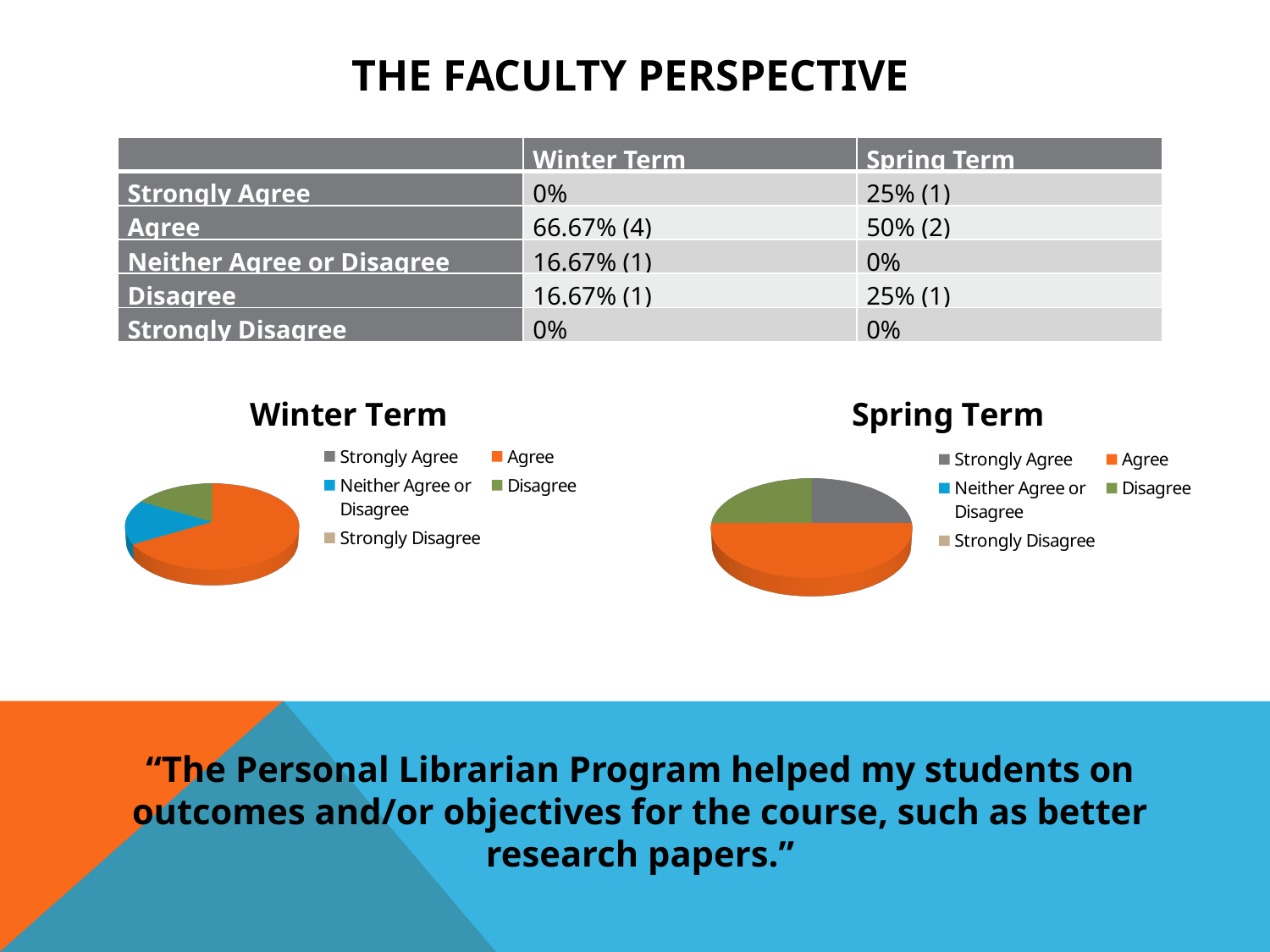
How many entries does the legend of the Spring Term chart list? 5 What type of chart is the Winter Term chart? pie chart In the Winter Term chart, what share of the pie is Agree? 66.67% In the Spring Term chart, is the Agree slice larger or smaller than the Strongly Agree slice? larger In the Winter Term pie chart, which category has the largest slice? Agree In the Spring Term chart, what share of the pie is Strongly Agree? 25% What colour represents Agree in both pie charts? orange In the Winter Term chart, what share of the pie is Neither Agree or Disagree? 16.67% In the Spring Term pie chart, which category has the largest slice? Agree What is the title of the pie chart on the right side of the slide? Spring Term In the Winter Term chart, is the Agree slice larger or smaller than the Disagree slice? larger